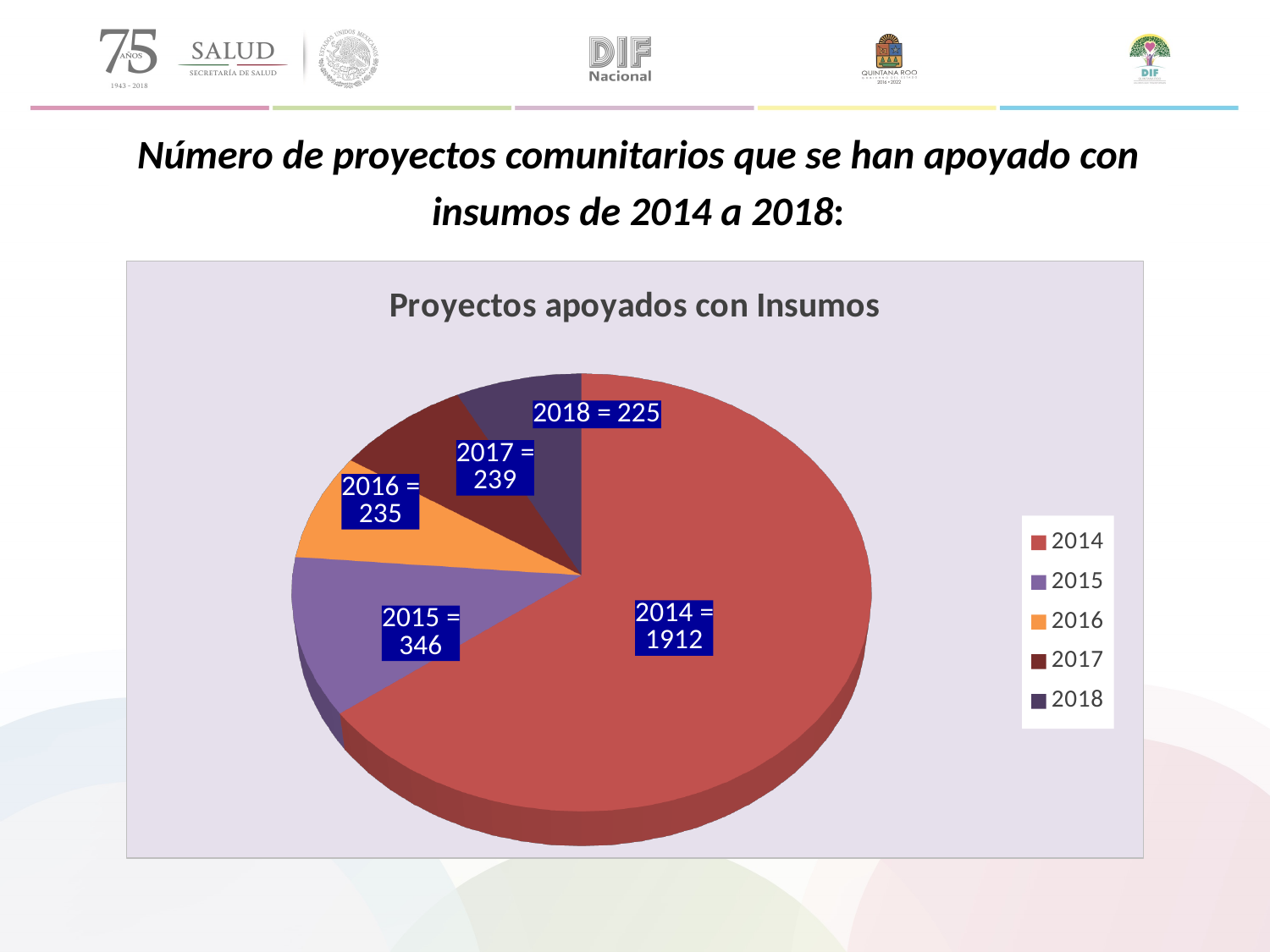
Which year has the largest slice of the pie? 2014 What type of chart is shown on the slide? Pie chart Which year has the smallest value? 2018 What is the total of all the values shown in the pie chart? 2957 How many years (slices) does the pie chart show? 5 Which is larger, the value for 2016 or the value for 2017? 2017 What is the difference between the values for 2015 and 2016? 111 How many projects were supported with supplies in 2014? 1912 What is the difference between the values for 2014 and 2015? 1566 What is the value shown for 2017? 239 What is the title of the chart? Proyectos apoyados con Insumos What is the value shown for 2015? 346